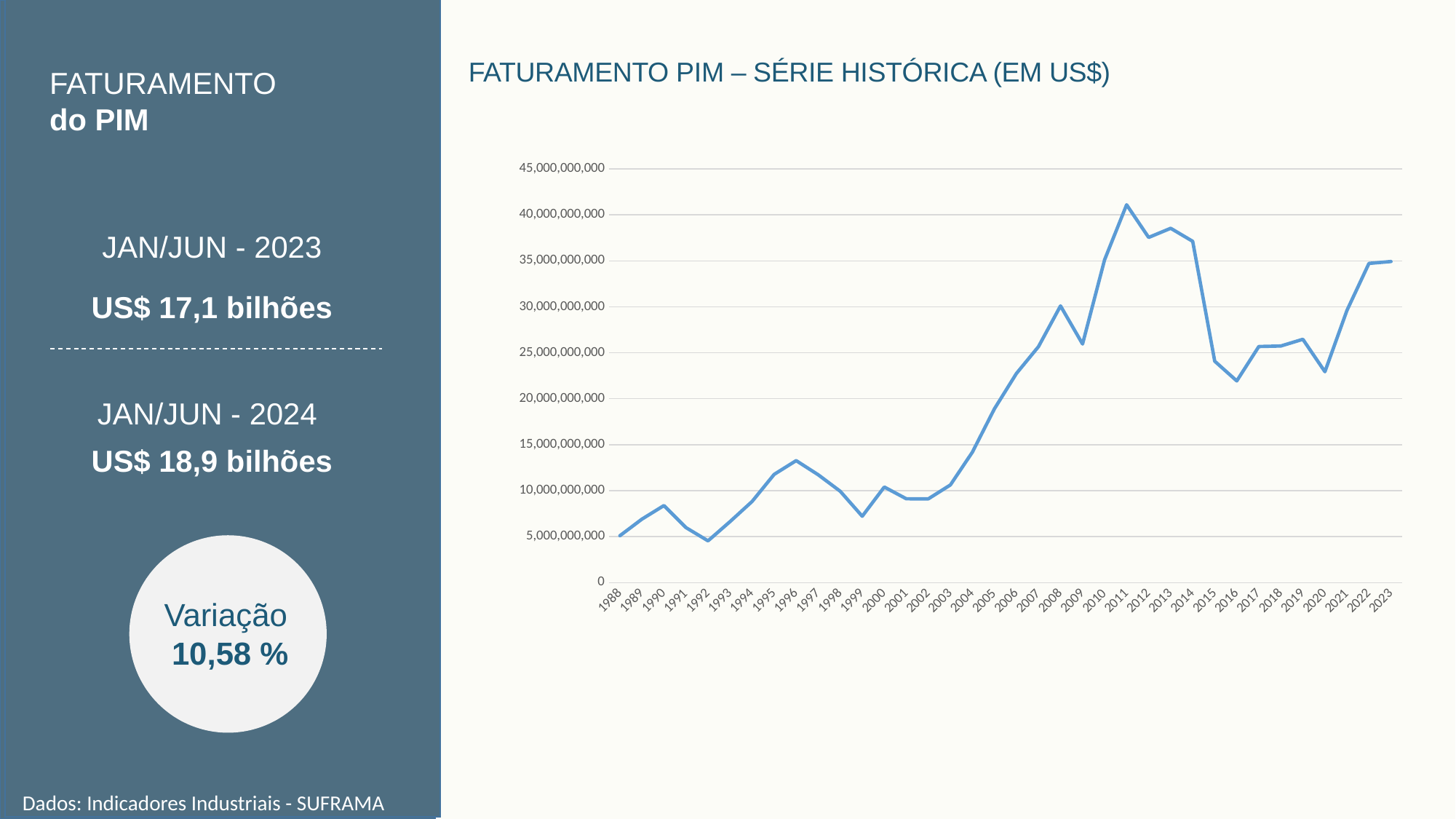
Which is larger, the value for 2008 or the value for 2009? 2008 What is the title of the chart? FATURAMENTO PIM – SÉRIE HISTÓRICA (EM US$) Is the value for 1999 greater or less than 10,000,000,000? less Is the value for 2008 greater or less than 25,000,000,000? greater Do the values rise or fall from 2011 to 2016? fall Which year has the highest value in the chart? 2011 What kind of chart is shown on the slide? line chart Is the value for 2011 greater or less than 40,000,000,000? greater How many years are plotted on the x axis of the chart? 36 Which is larger, the value for 2011 or the value for 2023? 2011